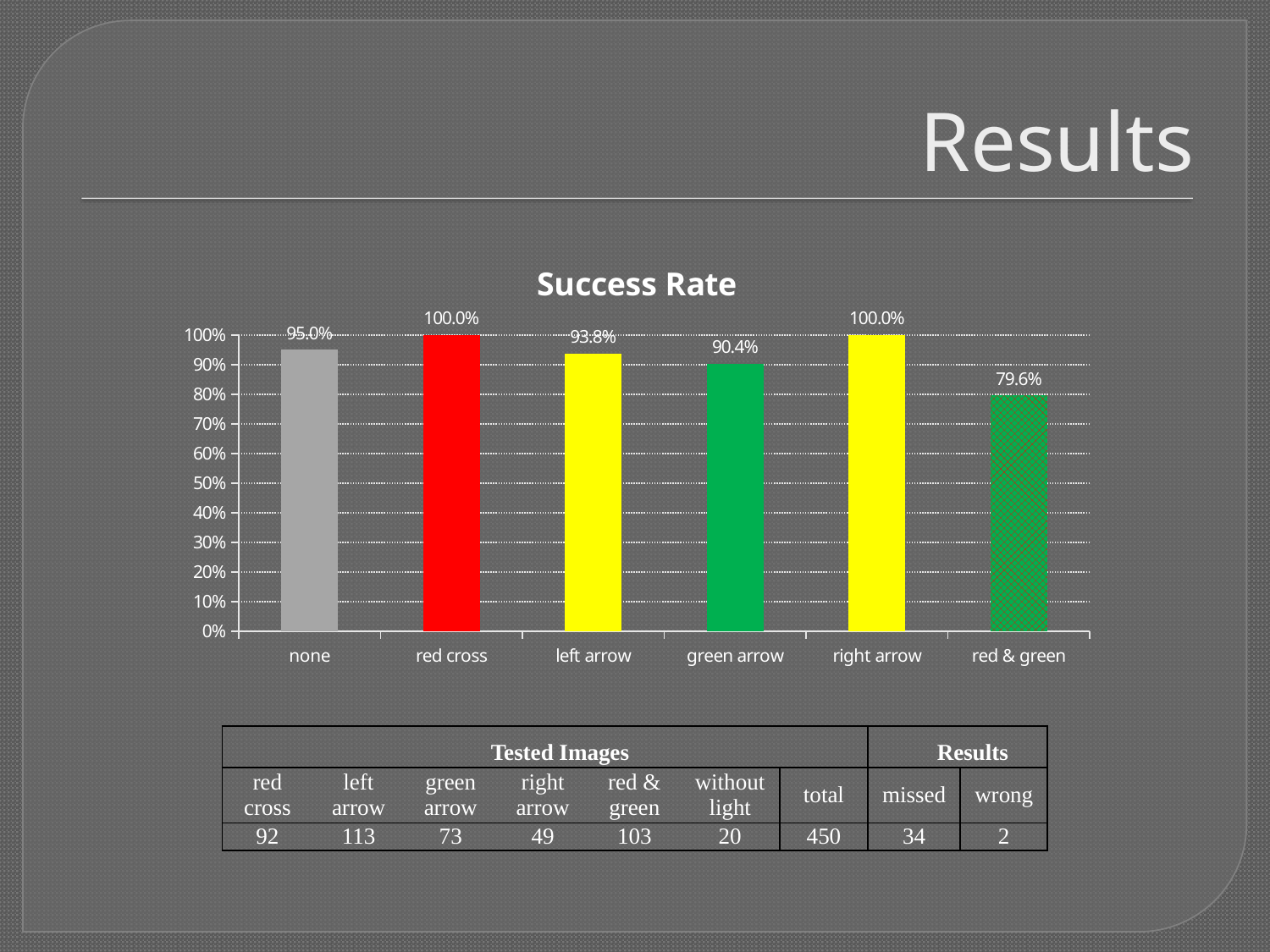
What is the success rate for 'red & green'? 79.6% What is the difference between the success rates for 'left arrow' and 'green arrow'? 3.4% Which category has the lowest success rate? red & green What is the title of the chart? Success Rate What is the difference between the success rates for 'none' and 'red & green'? 15.4% What is the success rate for 'none'? 95.0% What is the success rate for 'green arrow'? 90.4% How many categories are shown on the x axis of the chart? 6 What is the success rate for 'left arrow'? 93.8% Which categories have the highest success rate? red cross and right arrow Which has a higher success rate, 'none' or 'green arrow'? none What type of chart is shown on the slide? bar chart